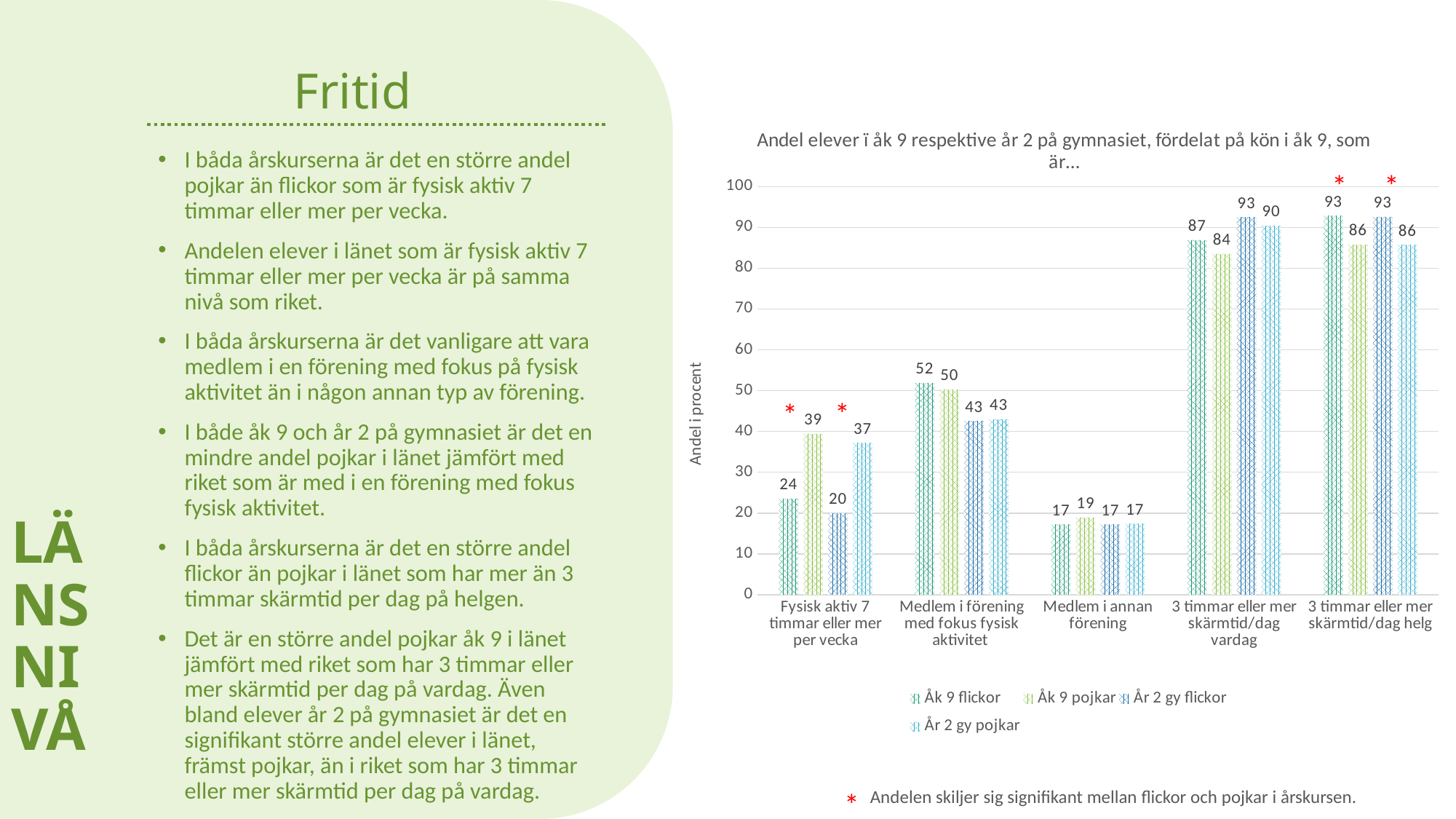
What is the value for Åk 9 flickor in the category '3 timmar eller mer skärmtid/dag vardag'? 87 How many series does the chart legend list? 4 What is the value for År 2 gy flickor in the category 'Medlem i förening med fokus fysisk aktivitet'? 43 What is the value for Åk 9 pojkar in the category 'Fysisk aktiv 7 timmar eller mer per vecka'? 39 In the category '3 timmar eller mer skärmtid/dag helg', which is larger: the value for Åk 9 flickor or the value for Åk 9 pojkar? Åk 9 flickor What is the difference between År 2 gy flickor and År 2 gy pojkar in the category '3 timmar eller mer skärmtid/dag vardag'? 3 What kind of chart is shown on the slide? bar chart Which series has the lowest value in the category 'Fysisk aktiv 7 timmar eller mer per vecka'? År 2 gy flickor How many categories are shown on the x axis of the chart? 5 Which series has the highest value in the category 'Medlem i förening med fokus fysisk aktivitet'? Åk 9 flickor What is the label of the y axis of the chart? Andel i procent What is the difference between Åk 9 pojkar and Åk 9 flickor in the category 'Fysisk aktiv 7 timmar eller mer per vecka'? 15